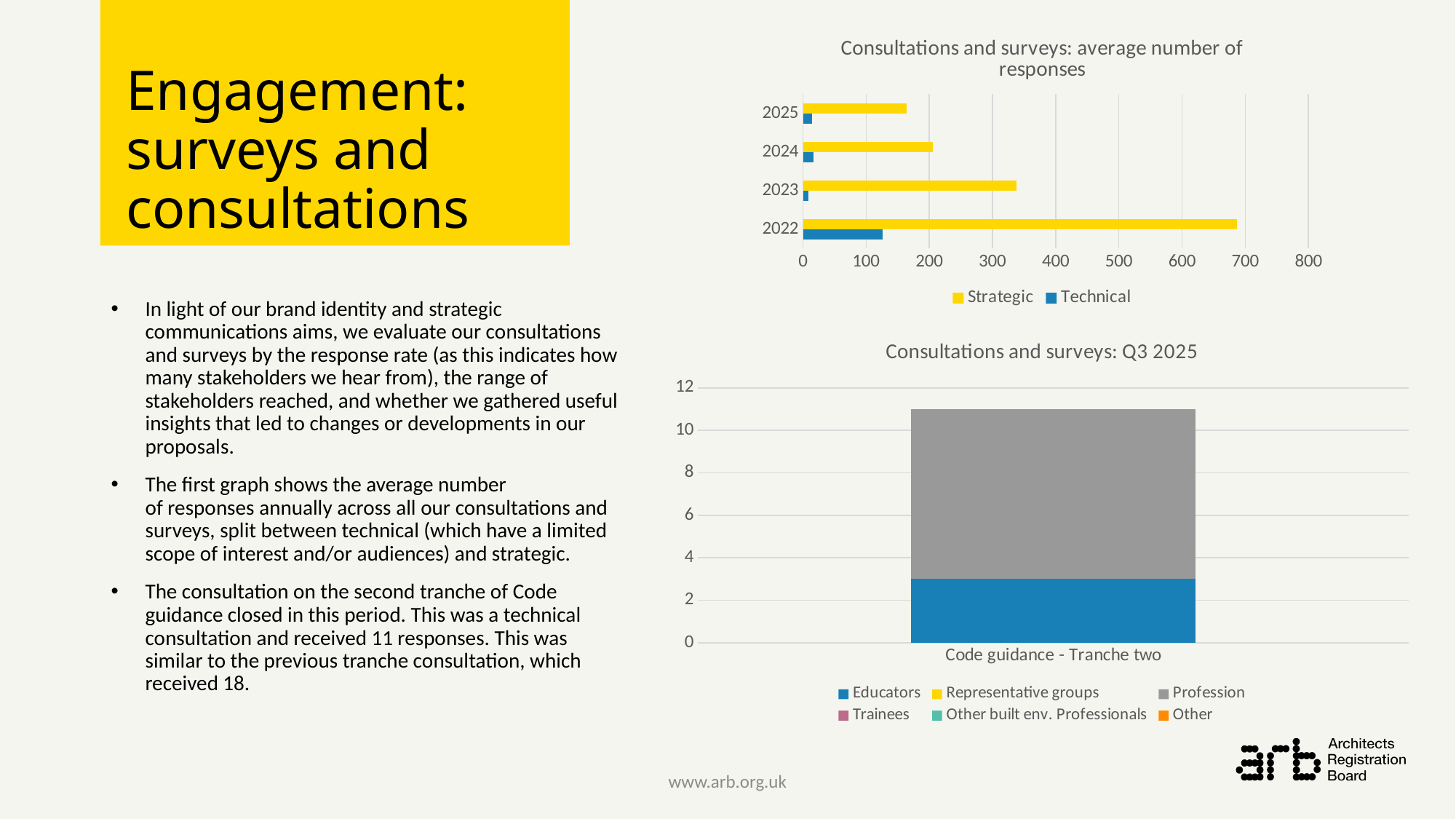
How many series does the legend of the 'Consultations and surveys: Q3 2025' chart list? 6 What is the category label on the x axis of the 'Consultations and surveys: Q3 2025' chart? Code guidance - Tranche two How many years are shown in the 'Consultations and surveys: average number of responses' chart? 4 In the 'Consultations and surveys: average number of responses' chart, is the Strategic value for 2023 greater or less than 300? greater In the 'Consultations and surveys: average number of responses' chart, is the Technical value for 2022 greater or less than 200? less In the 'Consultations and surveys: average number of responses' chart, is the Strategic value for 2022 greater or less than 600? greater In the 'Consultations and surveys: average number of responses' chart, which is larger for 2024: Strategic or Technical? Strategic In the 'Consultations and surveys: average number of responses' chart, which year has the highest Strategic value? 2022 How many series does the legend of the 'Consultations and surveys: average number of responses' chart list? 2 What kind of chart is the 'Consultations and surveys: average number of responses' chart? bar chart In the 'Consultations and surveys: average number of responses' chart, which year has the lowest Strategic value? 2025